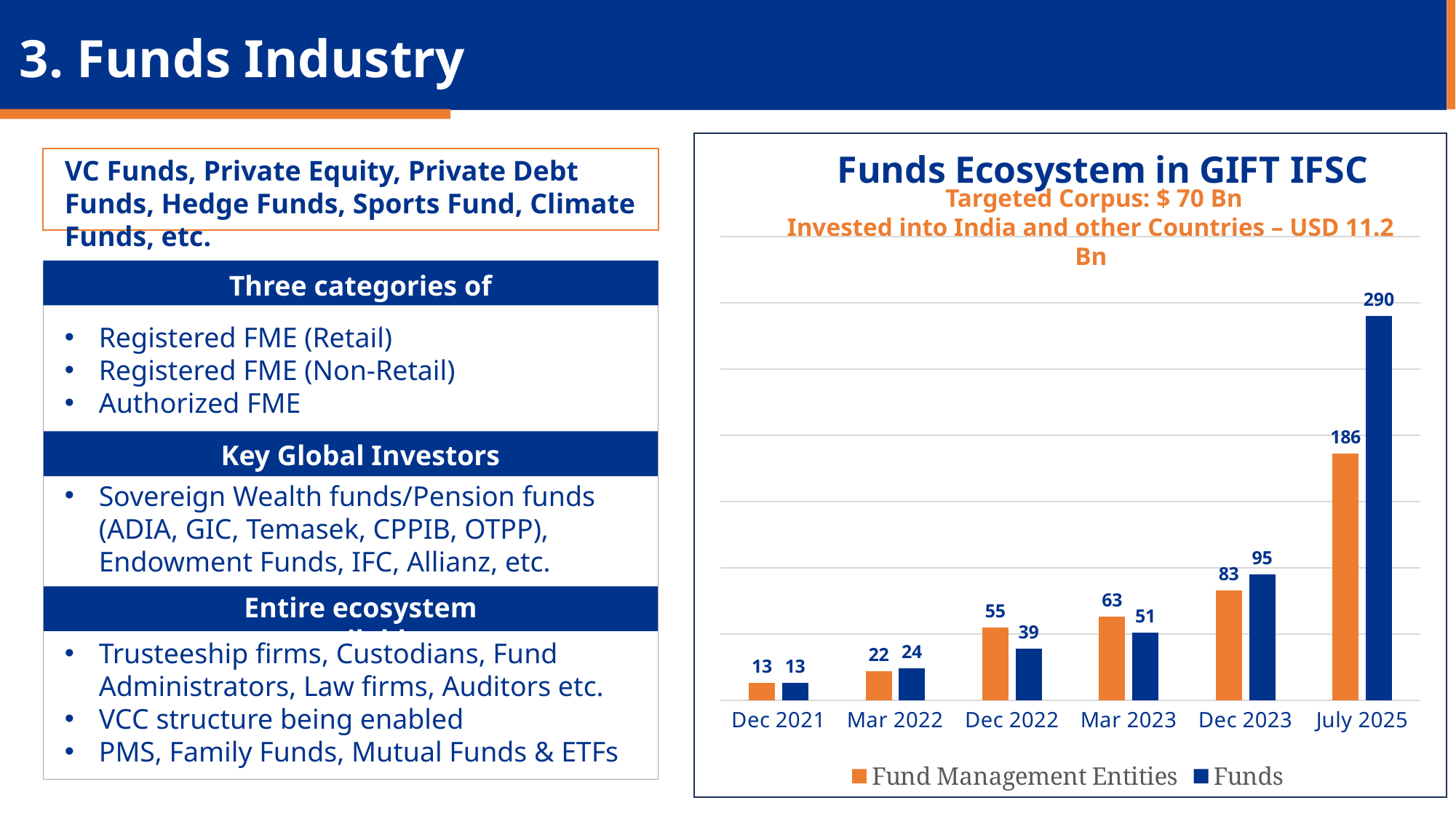
Which period has the lowest value for Funds? Dec 2021 What is the value for Fund Management Entities in Dec 2023? 83 What is the value for Funds in July 2025? 290 Which period has the highest value for Fund Management Entities? July 2025 In Mar 2023, which is larger: Fund Management Entities or Funds? Fund Management Entities What kind of chart is shown on the slide? Bar chart What is the difference between Funds and Fund Management Entities in July 2025? 104 What is the title of the chart? Funds Ecosystem in GIFT IFSC Do the values for Funds rise or fall from Dec 2021 to July 2025? Rise What is the value for Funds in Dec 2022? 39 How many time periods are shown on the x axis? 6 How many series does the legend list? 2